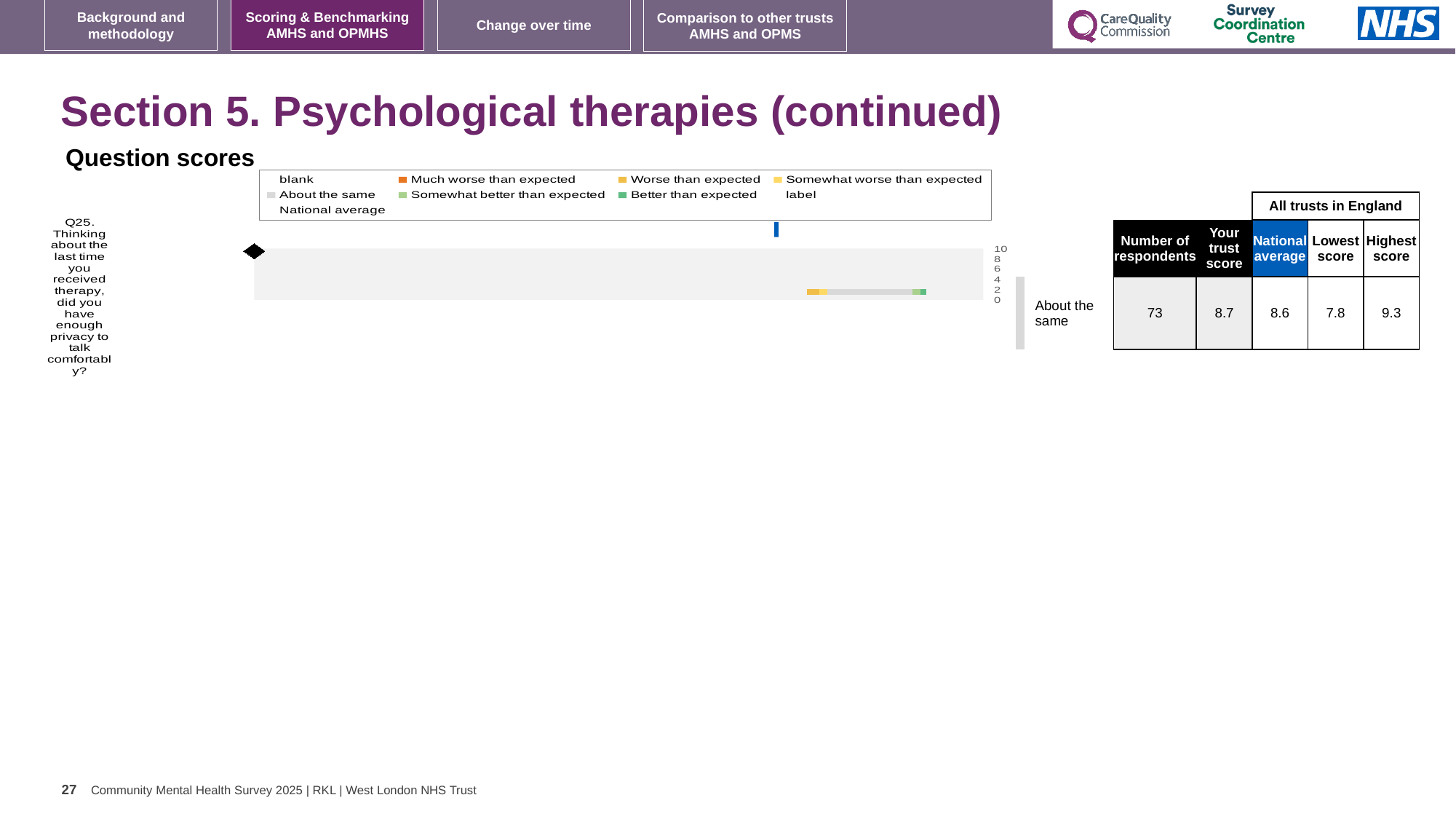
In the table beside the chart, what is the number of respondents for Q25? 73 What benchmark category is given for Q25 next to the chart? About the same What is the highest value shown on the chart's score axis? 10 In the table beside the chart, what is the lowest score among all trusts in England for Q25? 7.8 In the table beside the chart, what is 'Your trust score' for Q25? 8.7 What kind of chart is shown under 'Question scores'? bar chart How many entries does the chart legend list? 9 In the table beside the chart, what is the highest score among all trusts in England for Q25? 9.3 For Q25, which is larger: your trust score or the national average? Your trust score How many survey questions are plotted in the chart? 1 Which question number is plotted in the chart? Q25 In the table beside the chart, what is the national average for Q25? 8.6